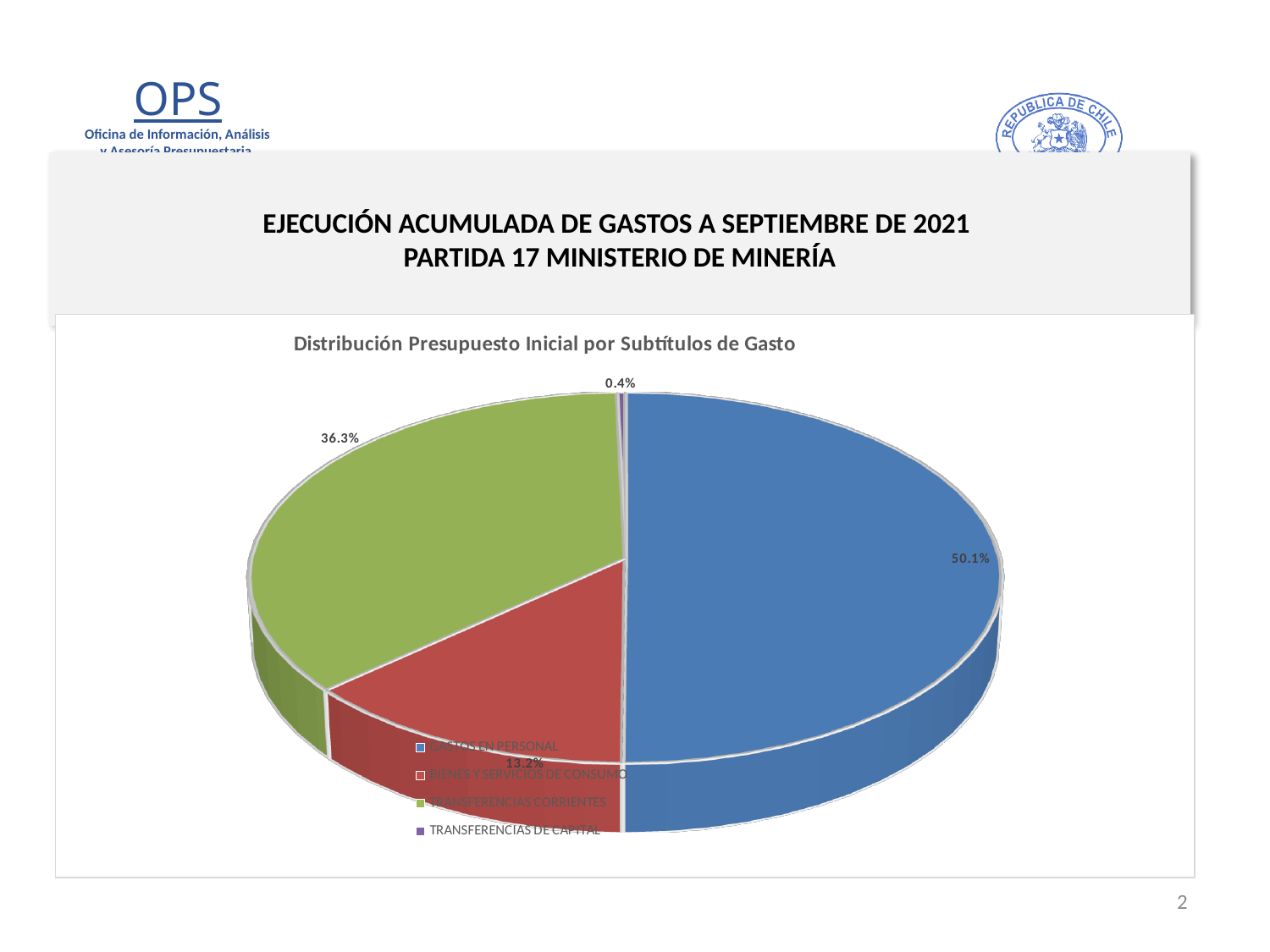
Which category has the largest slice of the pie? GASTOS EN PERSONAL What share of the pie does BIENES Y SERVICIOS DE CONSUMO represent? 13.2% What share of the pie does TRANSFERENCIAS DE CAPITAL represent? 0.4% How many categories does the legend list? 4 Which category has the smallest slice of the pie? TRANSFERENCIAS DE CAPITAL Which is larger, the share for TRANSFERENCIAS CORRIENTES or the share for BIENES Y SERVICIOS DE CONSUMO? TRANSFERENCIAS CORRIENTES What share of the pie does TRANSFERENCIAS CORRIENTES represent? 36.3% What kind of chart is shown on the slide? Pie chart What colour is the slice for TRANSFERENCIAS CORRIENTES? Green What is the difference in percentage points between GASTOS EN PERSONAL and TRANSFERENCIAS CORRIENTES? 13.8 What is the title of the chart? Distribución Presupuesto Inicial por Subtítulos de Gasto